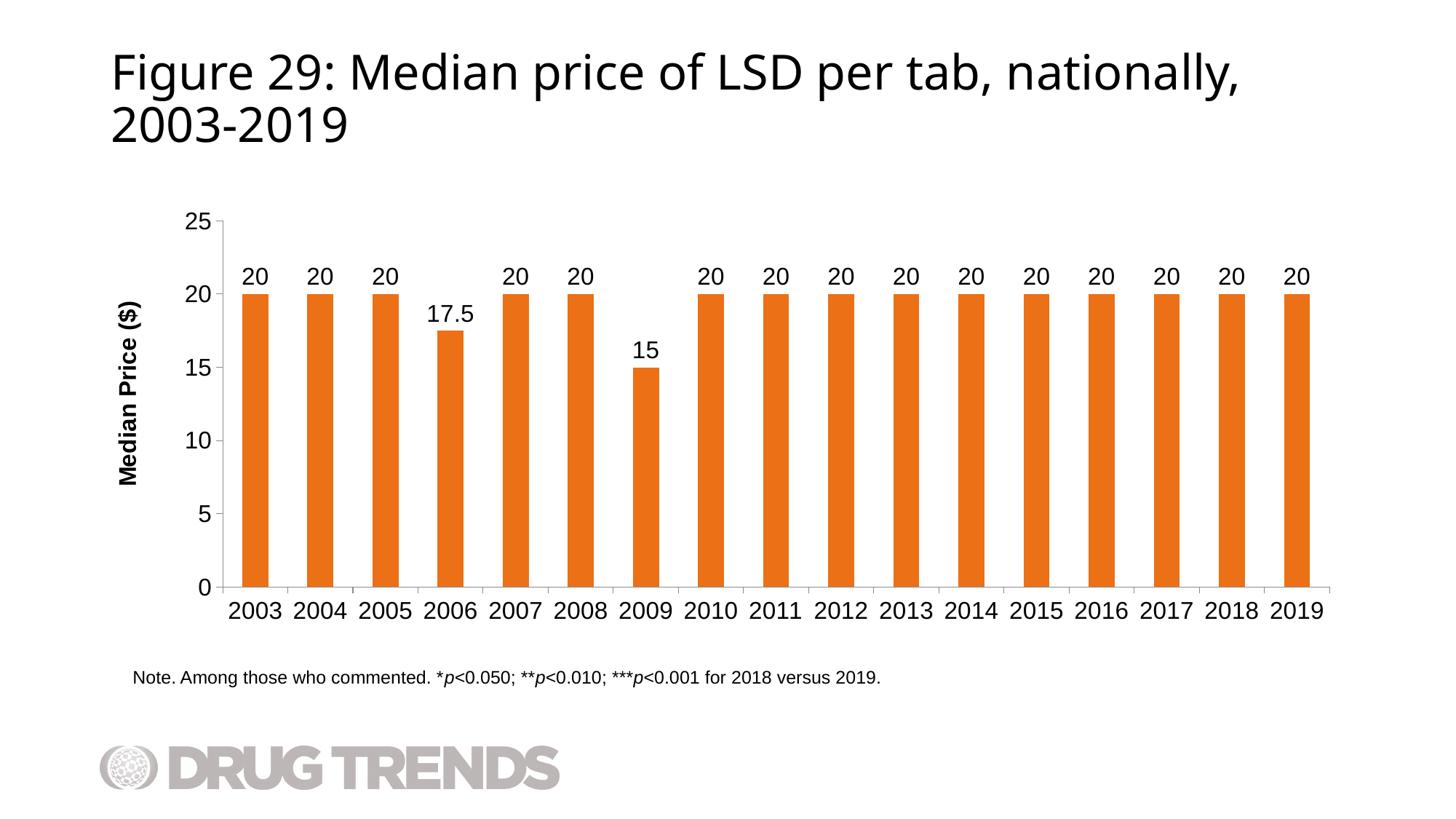
What is the difference between the median price in 2006 and the median price in 2009? 2.5 Which is larger, the median price in 2006 or the median price in 2009? 2006 What kind of chart is shown on the slide? bar chart What is the median price of LSD per tab in 2009? 15 What is the median price of LSD per tab in 2019? 20 What is the label of the y axis? Median Price ($) Is the value for 2009 greater or less than 20? less What is the title of the chart? Figure 29: Median price of LSD per tab, nationally, 2003-2019 What is the median price of LSD per tab in 2006? 17.5 Which year has the lowest median price of LSD per tab? 2009 How many years are shown on the x axis of the chart? 17 What is the difference between the median price in 2008 and the median price in 2009? 5